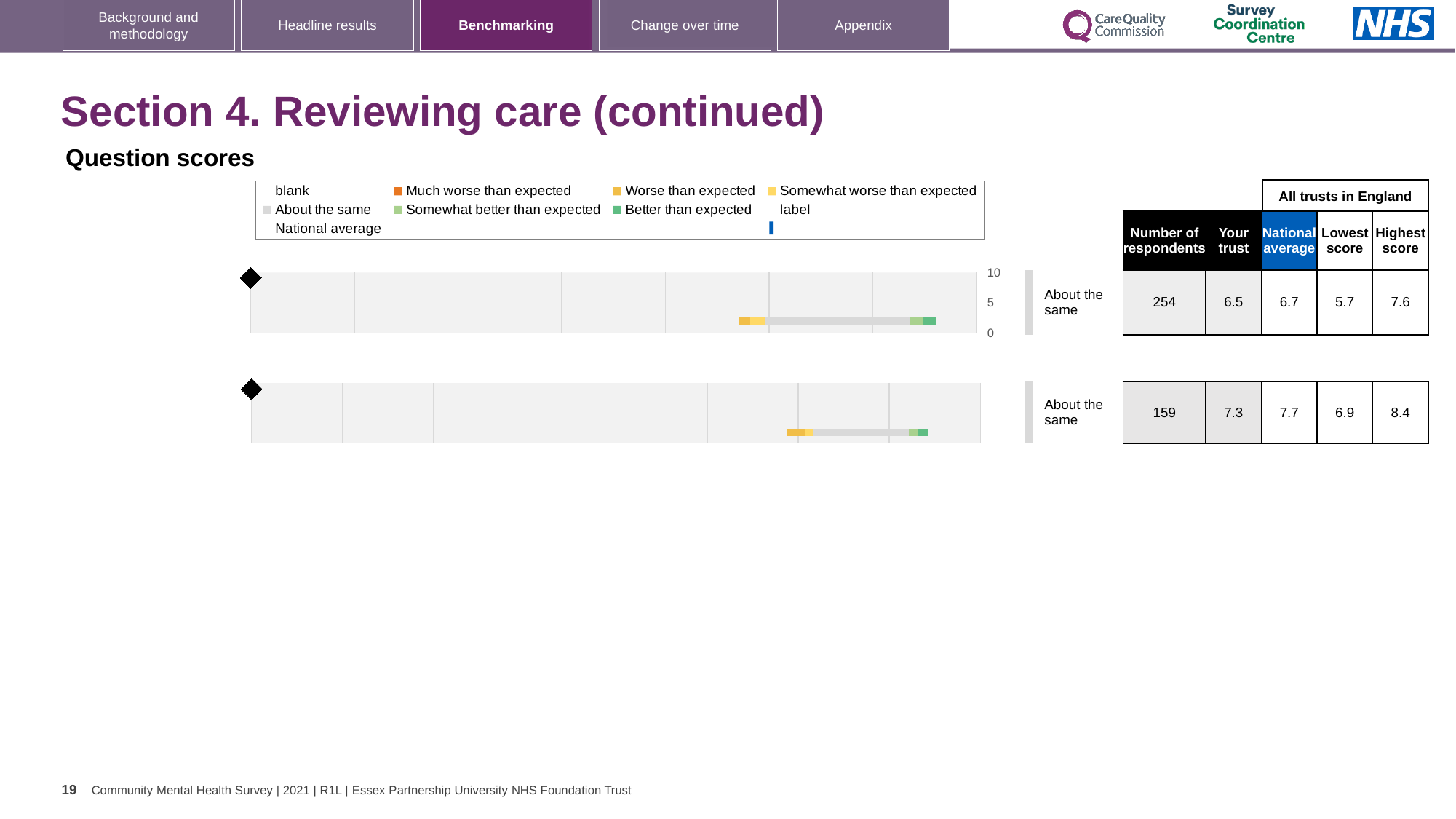
For the bottom chart, what is the 'Your trust' score? 7.3 For the top chart, what is the national average score? 6.7 What kind of chart is used to show the question scores on this slide? bar chart For the bottom chart, is the 'Your trust' score greater or less than 5? greater For the bottom chart, what is the highest score among all trusts in England? 8.4 For the bottom chart, what is the difference between the national average and the 'Your trust' score? 0.4 For the top chart, what is the difference between the highest score and the lowest score among all trusts in England? 1.9 For the top chart, how many respondents are there? 254 What benchmark category is shown next to the bottom chart? About the same How many question score charts are shown on the slide? 2 For the top chart, which is larger: the 'Your trust' score or the national average? National average For the top chart, what is the 'Your trust' score? 6.5